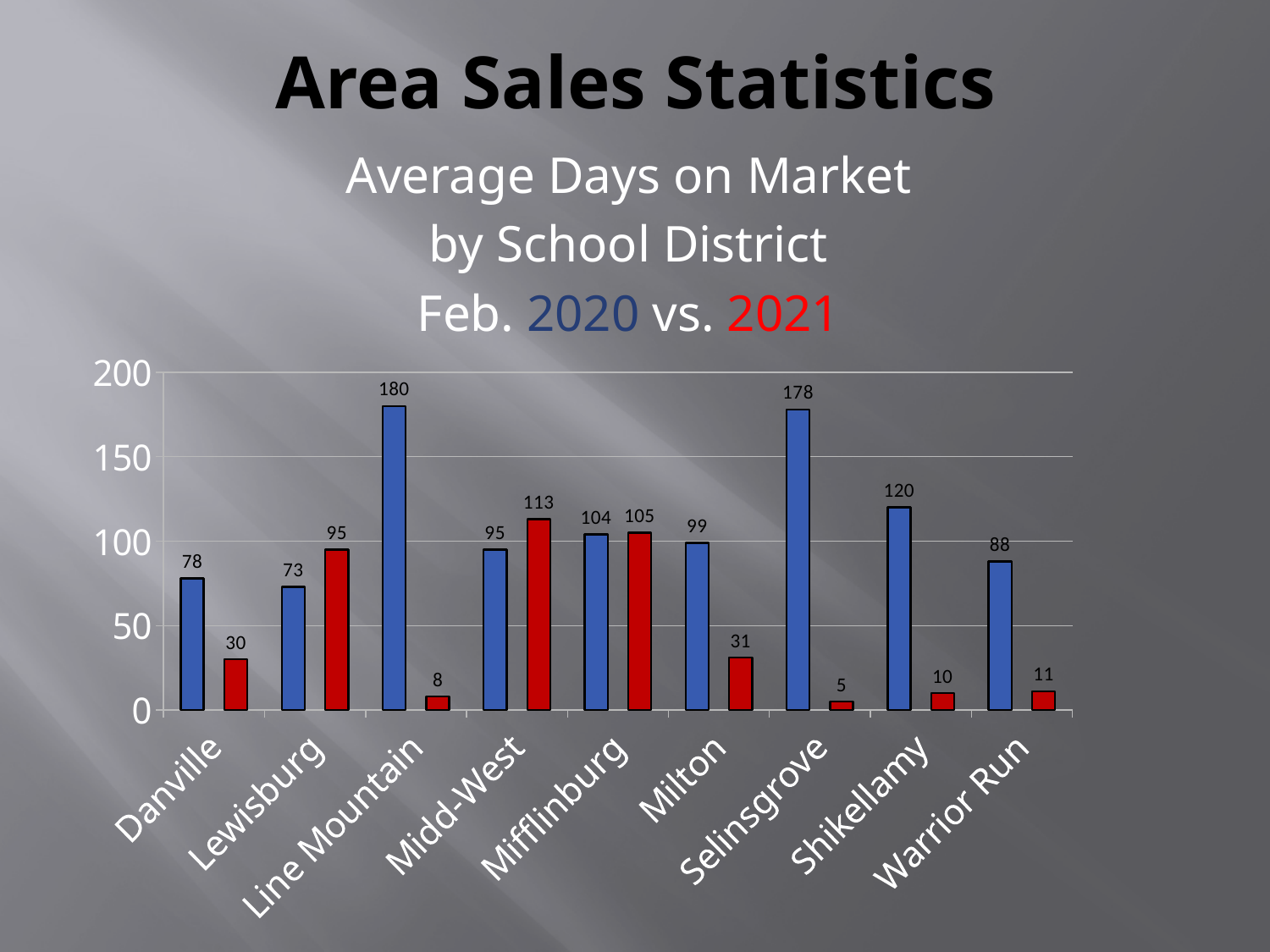
Which is larger for Lewisburg, the Feb. 2020 value or the Feb. 2021 value? Feb. 2021 What is the average days on market for Line Mountain in Feb. 2020? 180 Which colour represents the Feb. 2021 bars? red Which school district has the lowest Feb. 2021 average days on market? Selinsgrove What is the difference between the Feb. 2020 and Feb. 2021 values for Shikellamy? 110 How many school districts are shown on the x axis? 9 What type of chart is shown on the slide? bar chart What is the difference between the Feb. 2020 values for Line Mountain and Selinsgrove? 2 Is the Feb. 2020 value for Milton greater or less than 50? greater What is the Feb. 2021 value for Selinsgrove? 5 What is the average days on market for Midd-West in Feb. 2021? 113 Which school district has the highest Feb. 2020 average days on market? Line Mountain